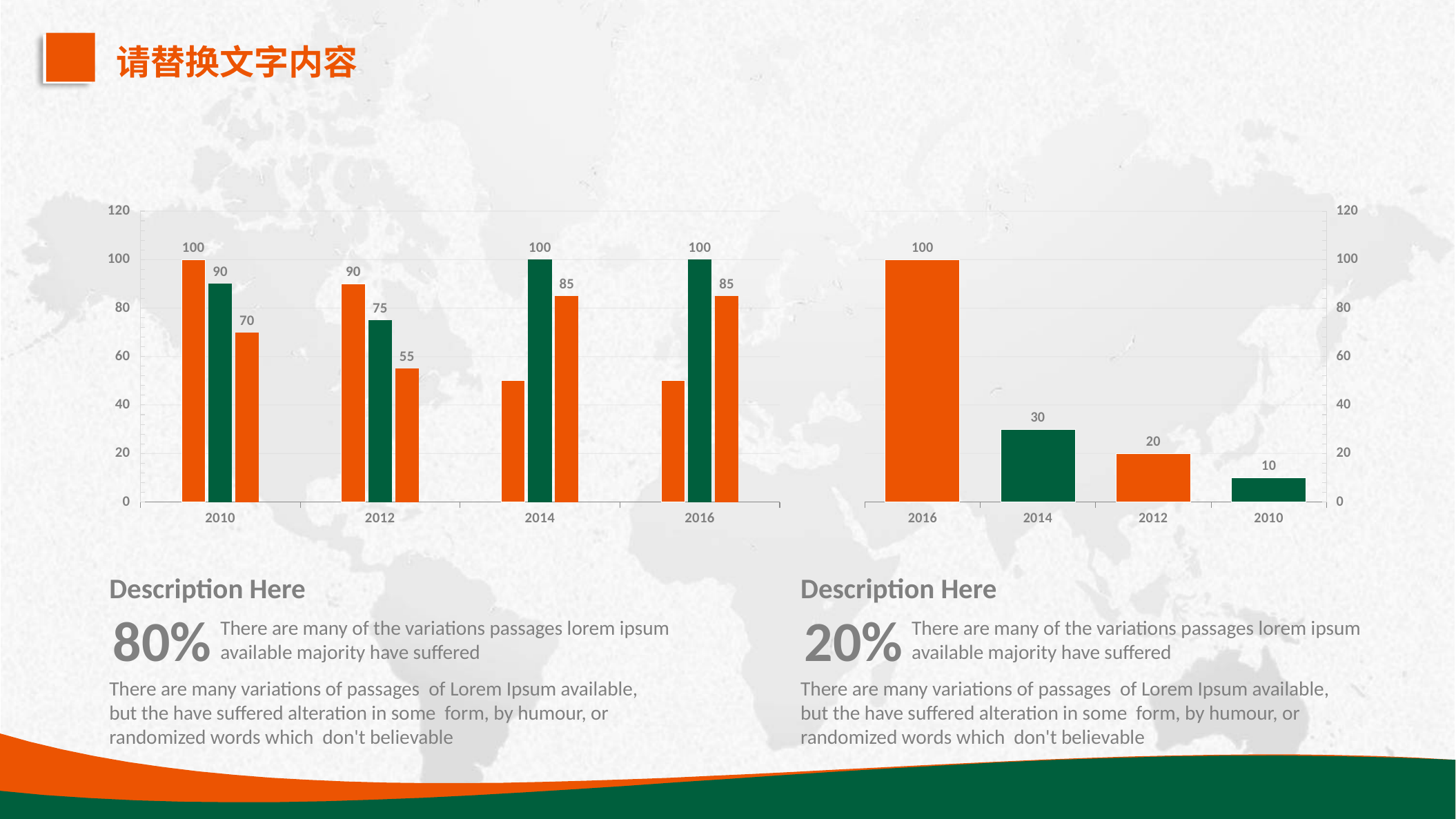
On the left chart, what is the difference between the middle bar for 2014 and the middle bar for 2012? 25 On the right chart, which year has the lowest value? 2010 What kind of chart is the right chart? bar chart On the left chart, what is the value of the middle (green) bar for 2012? 75 On the right chart, what is the value for 2016? 100 On the left chart, which year has the larger third (rightmost) bar, 2010 or 2012? 2010 On the right chart, what is the difference between the values for 2016 and 2014? 70 On the right chart, which year has the highest value? 2016 On the left chart, how many year categories are shown on the x axis? 4 On the left chart, is the value of the first (leftmost) bar for 2014 greater or less than 60? less On the right chart, what is the value for 2010? 10 On the left chart, what is the value of the third (rightmost) bar for 2010? 70